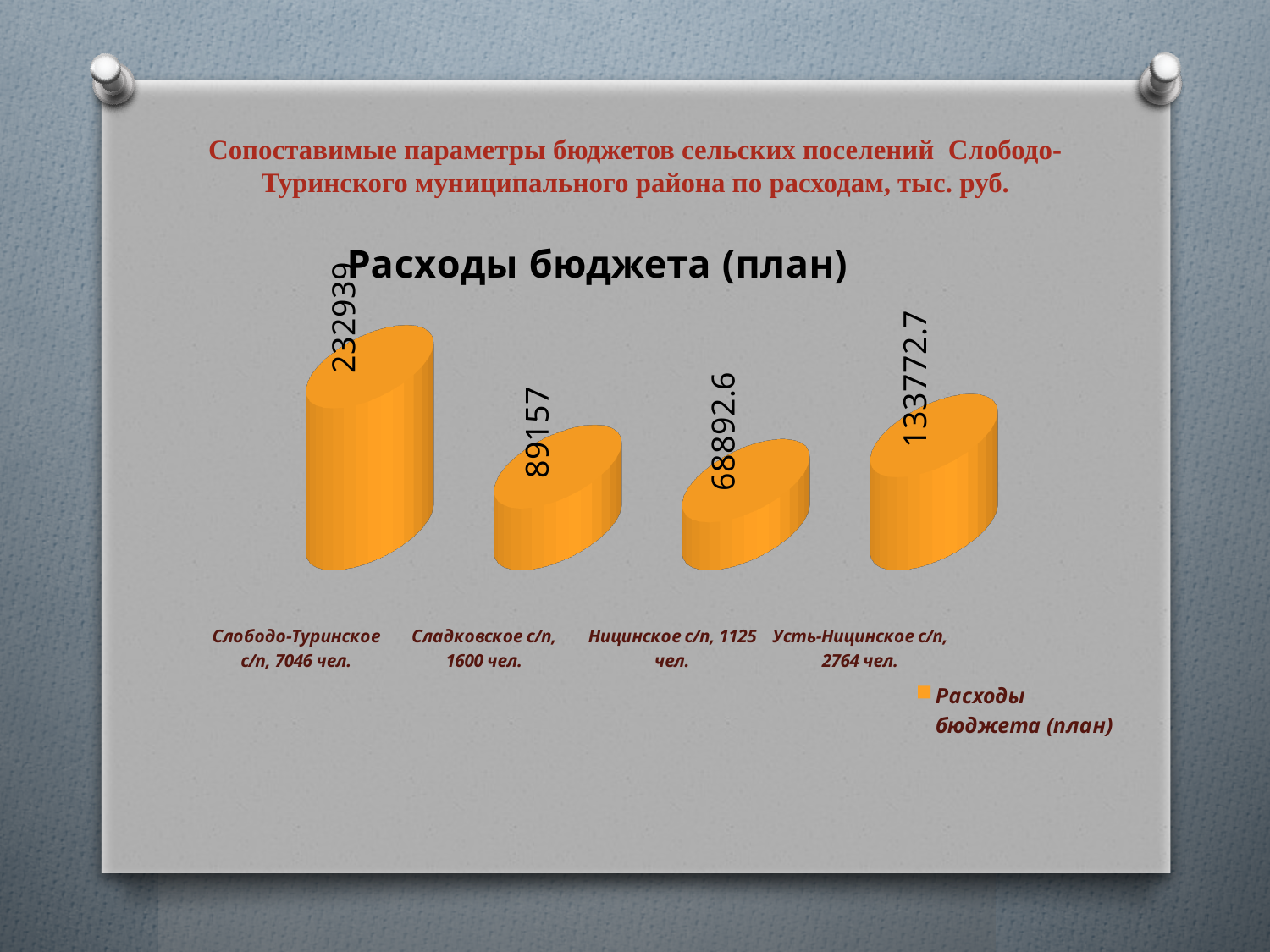
How many settlements (categories) are shown in the chart? 4 What is the value for Усть-Ницинское с/п in the chart Расходы бюджета (план)? 133772.7 What kind of chart is shown on the slide? bar chart What is the value for Сладковское с/п in the chart Расходы бюджета (план)? 89157 What is the value for Слободо-Туринское с/п in the chart Расходы бюджета (план)? 232939 Which settlement has the lowest planned budget expenditure in the chart? Ницинское с/п What is the title of the chart on the slide? Расходы бюджета (план) What is the difference between the values for Усть-Ницинское с/п and Ницинское с/п? 64880.1 What is the difference between the values for Слободо-Туринское с/п and Сладковское с/п? 143782 Which settlement has the highest planned budget expenditure in the chart? Слободо-Туринское с/п What is the value for Ницинское с/п in the chart Расходы бюджета (план)? 68892.6 Which is larger: the value for Сладковское с/п or the value for Усть-Ницинское с/п? Усть-Ницинское с/п